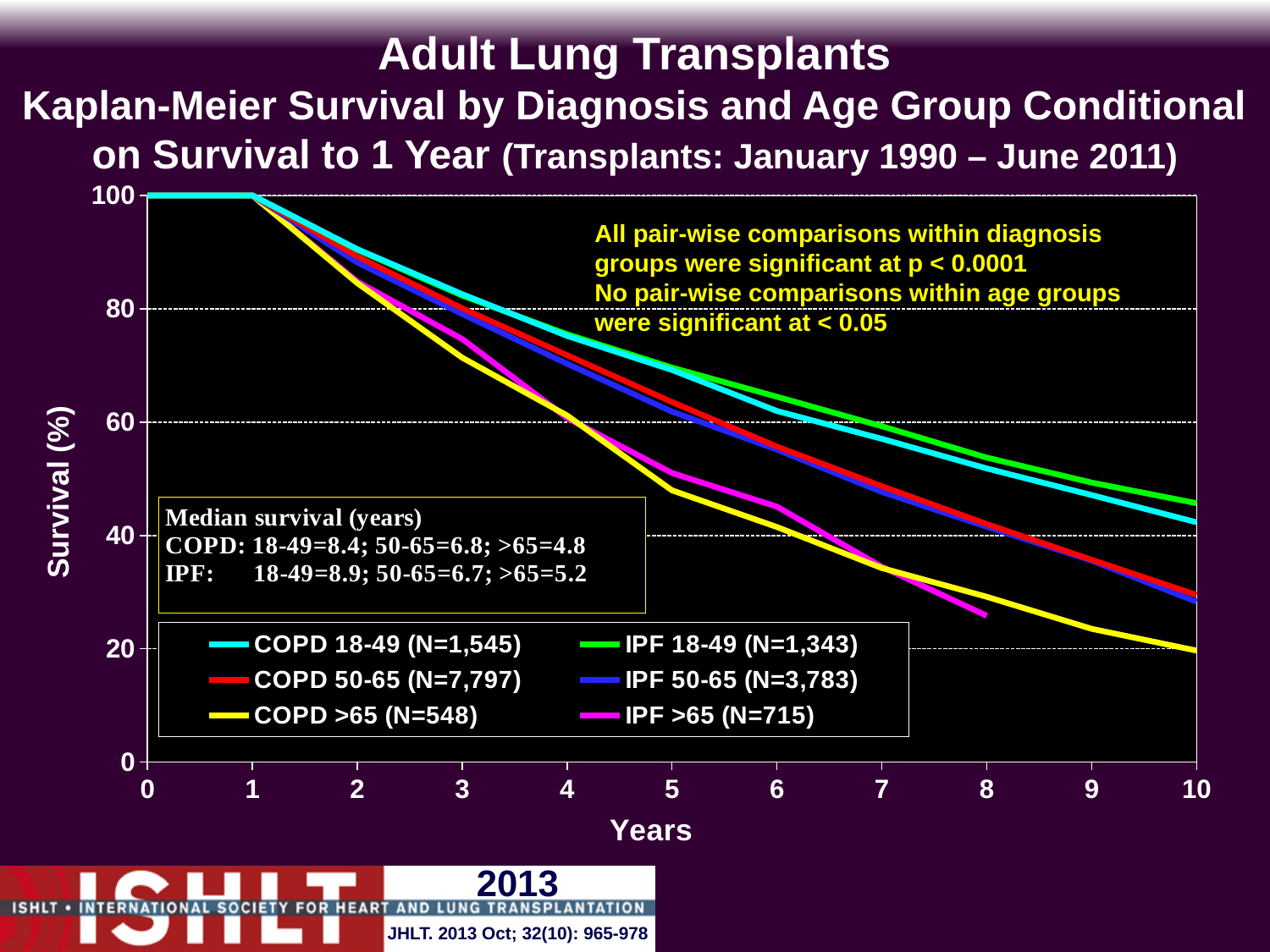
According to the median survival box, what is the median survival in years for IPF patients aged 18-49? 8.9 According to the legend, what is the N for the COPD 50-65 group? 7,797 Which series has the lowest survival at year 10? COPD >65 (N=548) Do the survival curves rise or fall as years increase? fall What is the difference in median survival (years) between IPF 18-49 and COPD 18-49? 0.5 Is the survival for COPD >65 at year 5 greater or less than 60? less What type of chart is shown on the slide? line chart According to the median survival box, what is the median survival in years for COPD patients aged >65? 4.8 How many series does the legend list? 6 Is the survival for IPF 18-49 at year 10 greater or less than 40? greater What is the label of the y axis? Survival (%) Which has the larger median survival: COPD 18-49 or IPF 18-49? IPF 18-49